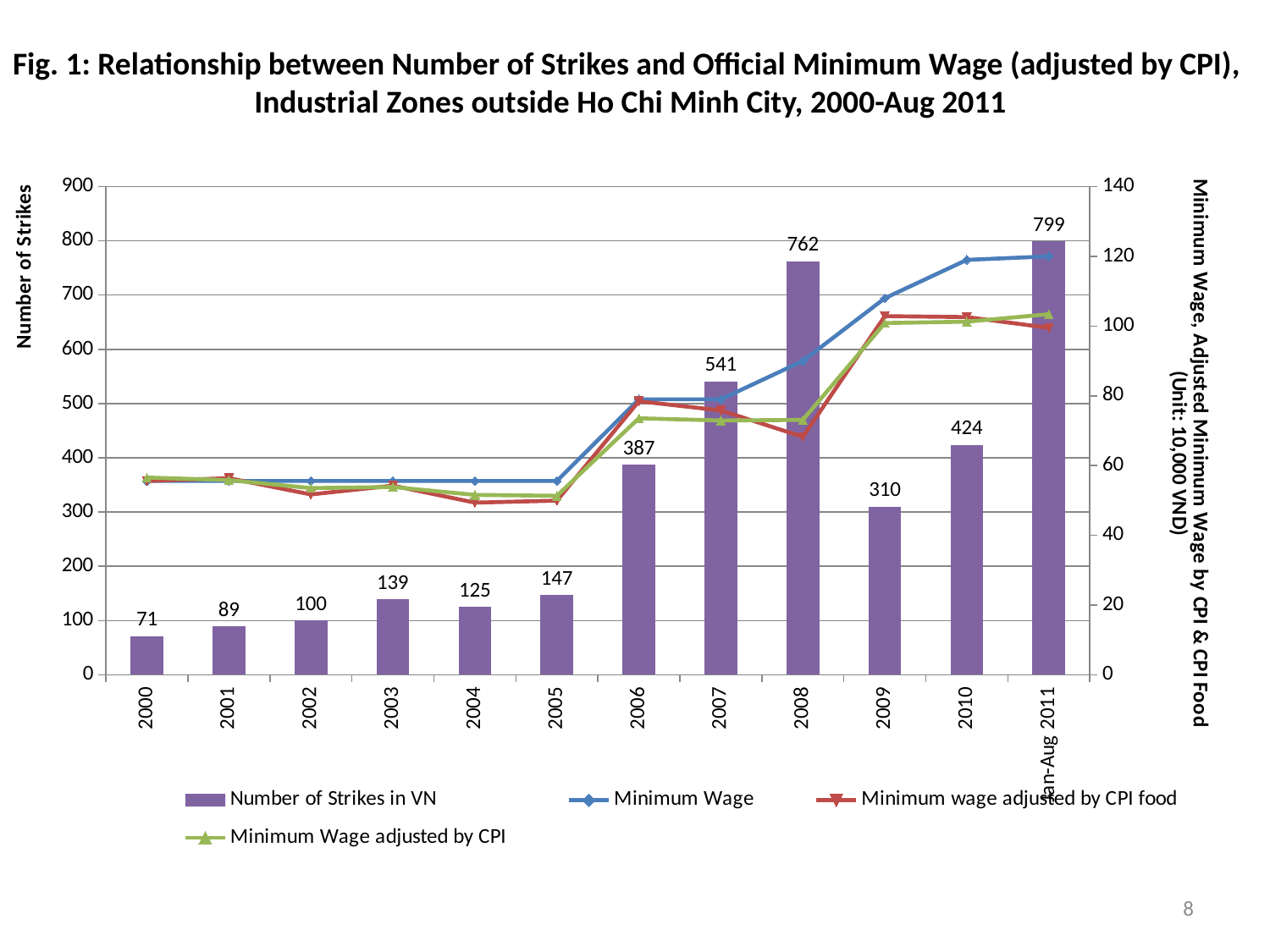
Which year has the lowest number of strikes? 2000 Which year had more strikes, 2007 or 2010? 2007 Is the Minimum wage adjusted by CPI food value for 2008 greater or less than 80? less How many series does the legend list? 4 What is the label of the left vertical axis? Number of Strikes What is the difference in the number of strikes between 2008 and 2009? 452 How many time periods are shown on the x axis? 12 Which period has the highest number of strikes? Jan-Aug 2011 What is the number of strikes shown for Jan-Aug 2011? 799 How many strikes were recorded in 2008? 762 What is the number of strikes shown for 2004? 125 Is the Minimum Wage value for 2010 greater or less than 100? greater